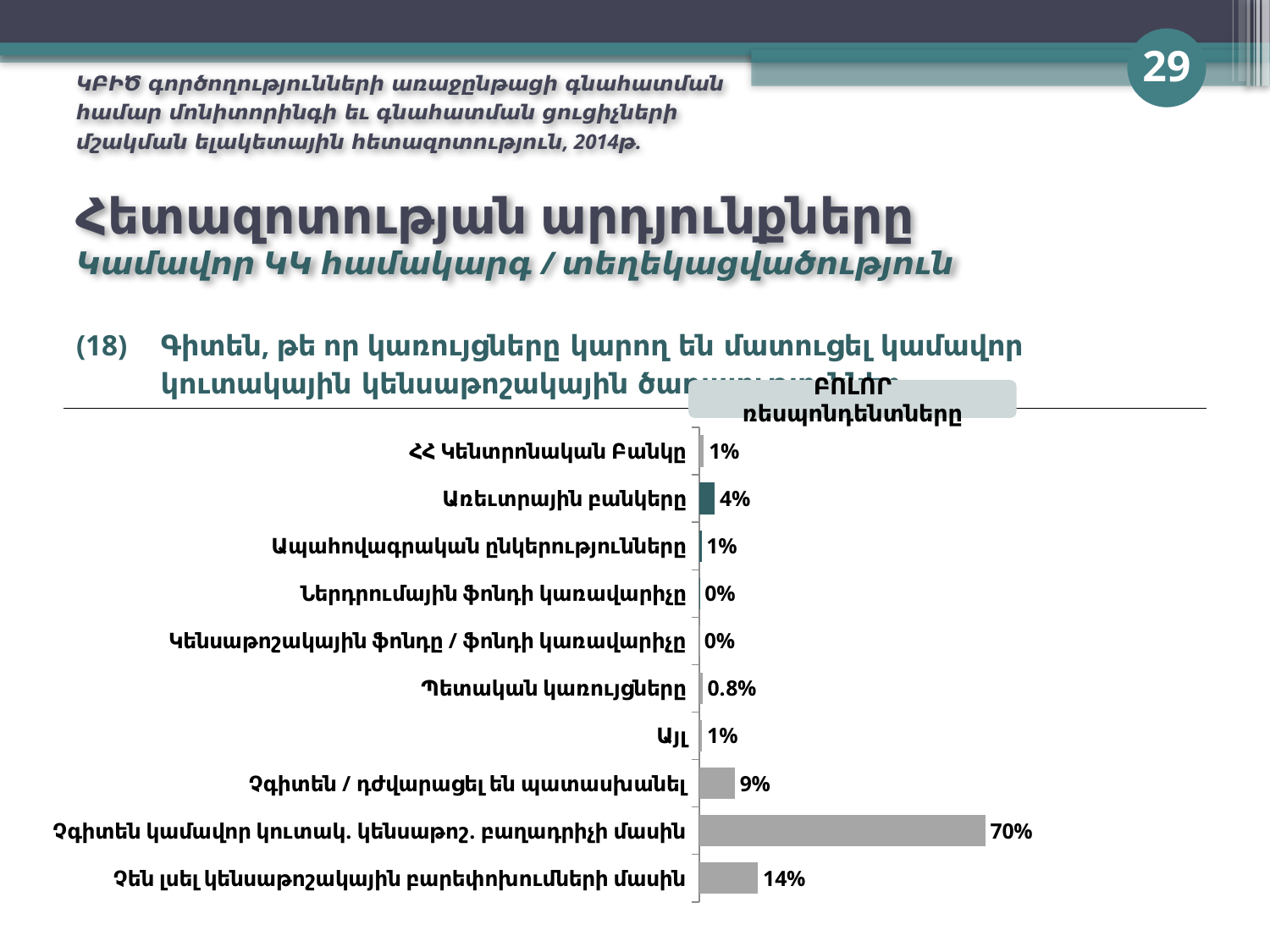
What is the value for "Չեն լսել կենսաթոշակային բարեփոխումների մասին"? 14% What kind of chart is shown on the slide? Bar chart What is the difference between the values for "Չգիտեն / դժվարացել են պատասխանել" and "Առեւտրային բանկերը"? 5% What is the difference between the values for "Չգիտեն կամավոր կուտակ. կենսաթոշ. բաղադրիչի մասին" and "Չեն լսել կենսաթոշակային բարեփոխումների մասին"? 56% How many categories are shown in the chart? 10 Which is larger: the value for "Առեւտրային բանկերը" or the value for "ՀՀ Կենտրոնական Բանկը"? Առեւտրային բանկերը What is the value for "Պետական կառույցները"? 0.8% What is the value for "Չգիտեն / դժվարացել են պատասխանել"? 9% What is the legend label shown above the chart? ԲՈԼՈՐ ռեսպոնդենտները Which category has the highest value? Չգիտեն կամավոր կուտակ. կենսաթոշ. բաղադրիչի մասին What is the value for "Առեւտրային բանկերը"? 4% What is the value for "Ներդրումային ֆոնդի կառավարիչը"? 0%